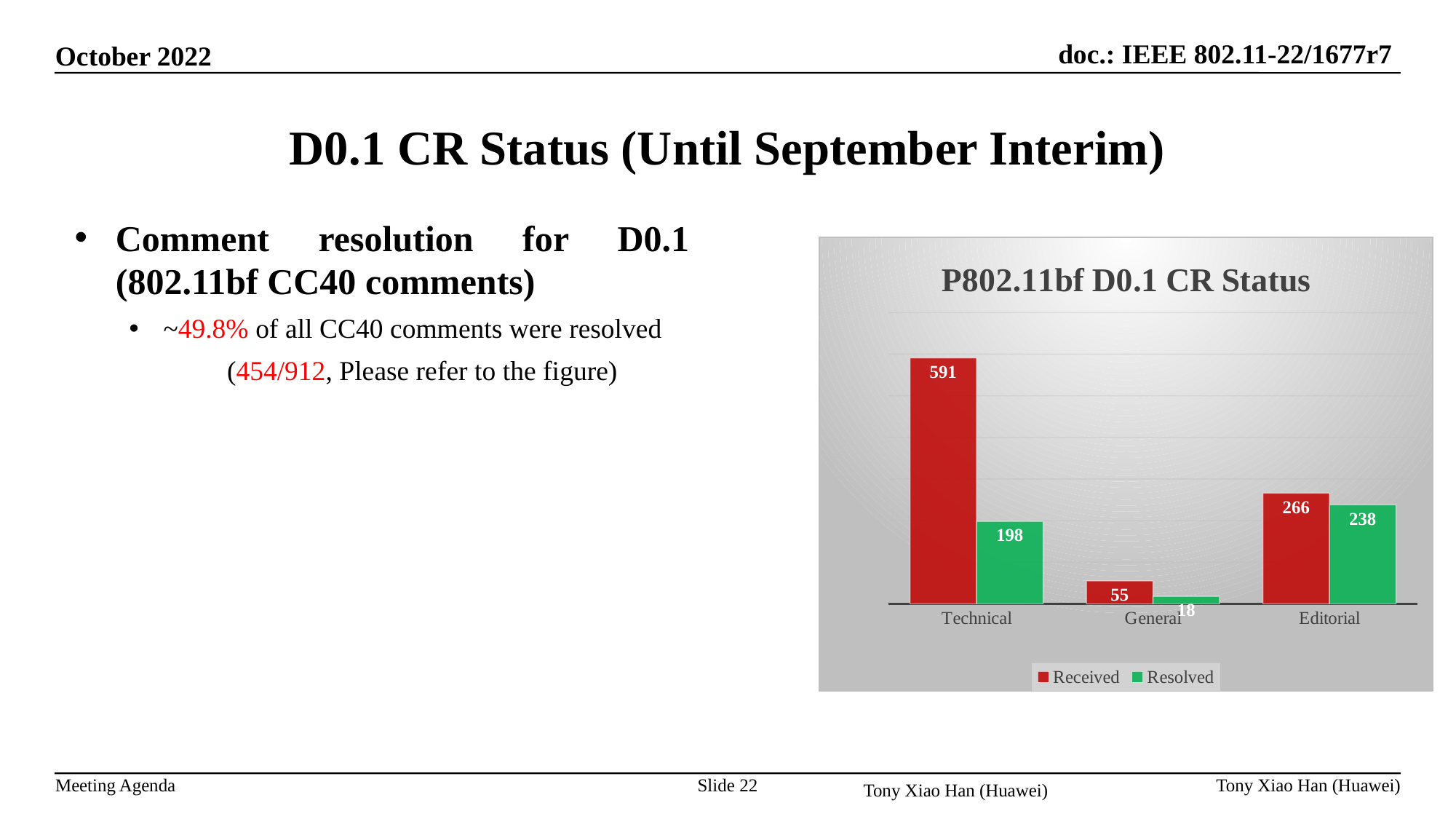
What is the difference between Received and Resolved for Technical? 393 What is the Resolved value for Editorial? 238 What type of chart is shown on the slide? bar chart Which is larger for Editorial, Received or Resolved? Received How many categories are shown on the x axis of the chart? 3 Which category has the lowest Resolved value? General What is the Received value for Technical? 591 What is the Resolved value for General? 18 Which series is shown in green in the chart? Resolved What is the title of the chart? P802.11bf D0.1 CR Status How many series does the chart legend list? 2 Which category has the highest Received value? Technical